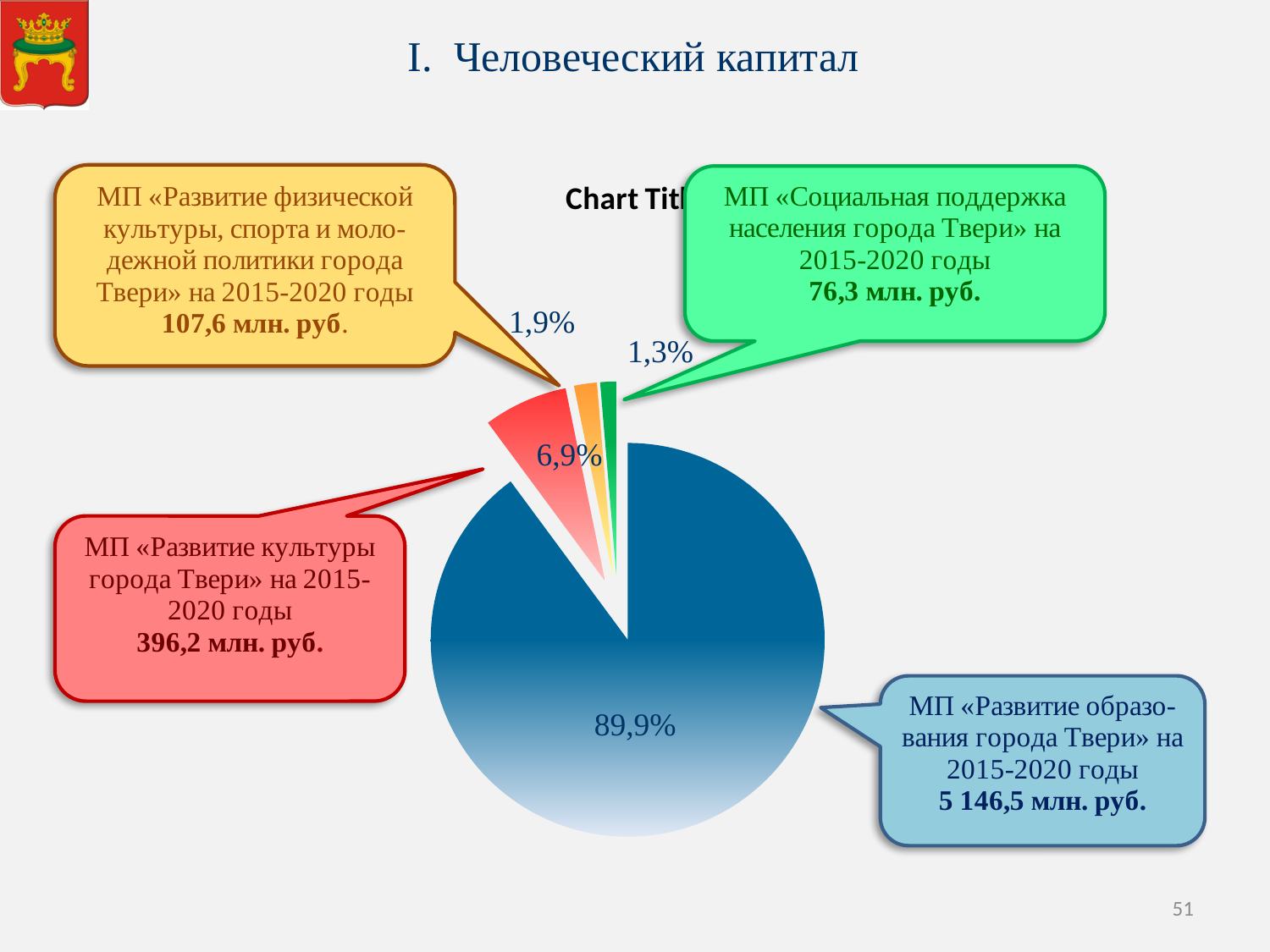
Which programme has the largest slice of the pie? МП «Развитие образования города Твери» What is the amount for the «Развитие физической культуры, спорта и молодежной политики города Твери» programme for 2015-2020? 107,6 млн. руб. What is the amount for the «Развитие образования города Твери» programme for 2015-2020? 5 146,5 млн. руб. What is the amount for the «Социальная поддержка населения города Твери» programme for 2015-2020? 76,3 млн. руб. What is the difference between the amounts for the «Развитие культуры» programme and the «Развитие физической культуры, спорта и молодежной политики» programme? 288,6 млн. руб. What is the amount for the «Развитие культуры города Твери» programme for 2015-2020? 396,2 млн. руб. What kind of chart is shown on the slide? pie chart Which is larger: the amount for the «Развитие культуры» programme or the «Социальная поддержка населения» programme? МП «Развитие культуры города Твери» What share of the pie does the «Развитие образования города Твери» programme account for? 89,9% What colour is the slice for the «Развитие образования города Твери» programme? blue Which slice is smaller: the one for the «Развитие физической культуры, спорта и молодежной политики» programme or the one for the «Социальная поддержка населения» programme? МП «Социальная поддержка населения города Твери» What share of the pie does the «Развитие культуры города Твери» programme account for? 6,9%